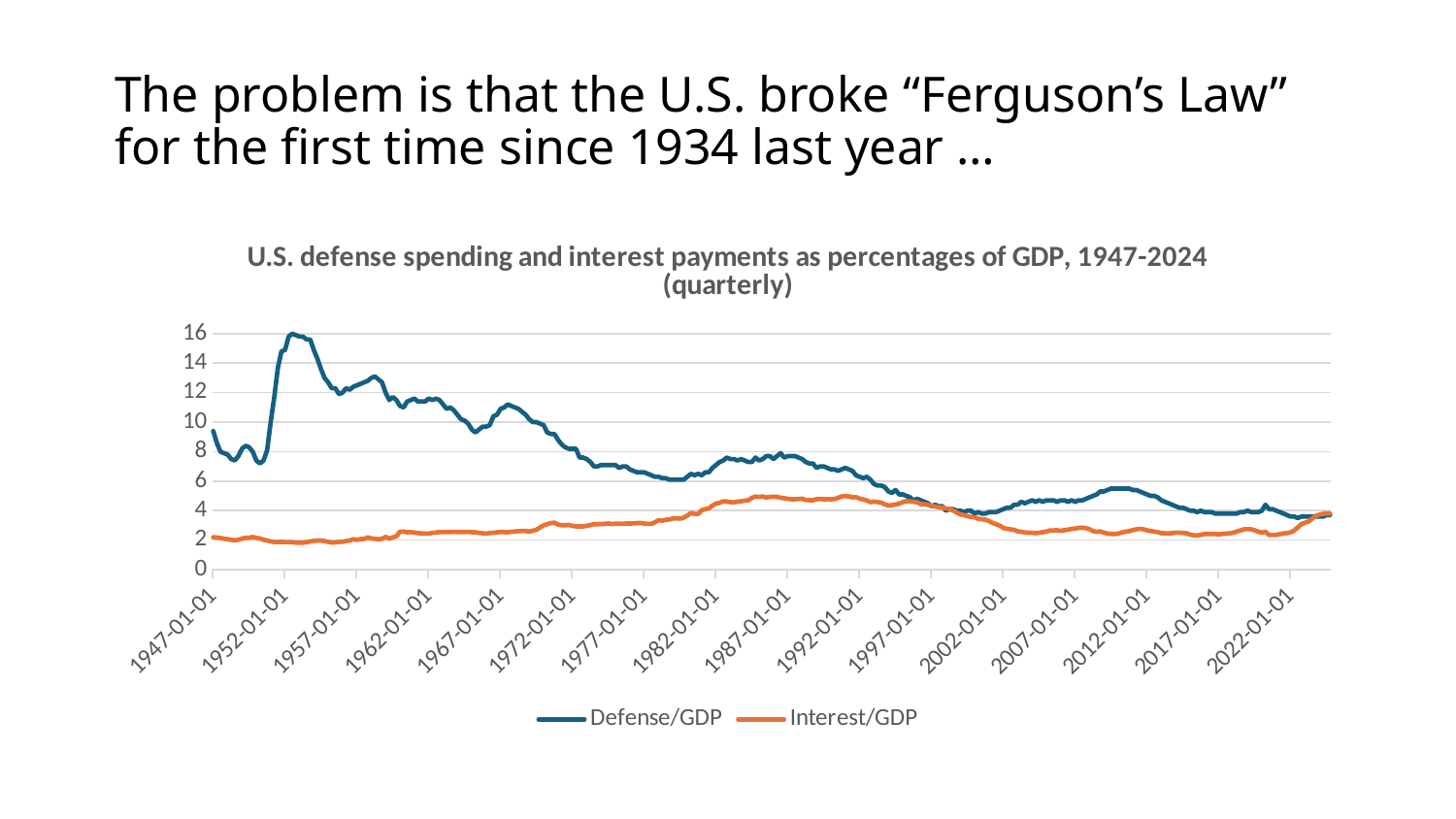
Is the value of Interest/GDP at 2007-01-01 greater or less than 4? less Does Defense/GDP generally rise or fall between 1952-01-01 and 1977-01-01? Fall Is the value of Interest/GDP at 1947-01-01 greater or less than 4? less How many series does the legend list? 2 Is the value of Defense/GDP at 2012-01-01 greater or less than 4? greater How many date labels are shown on the x axis? 16 What kind of chart is shown on the slide? Line chart Which series reaches the highest value anywhere on the chart? Defense/GDP What colour is the Interest/GDP line? Orange Which series has the larger value at 1967-01-01, Defense/GDP or Interest/GDP? Defense/GDP What are the two series named in the legend? Defense/GDP and Interest/GDP